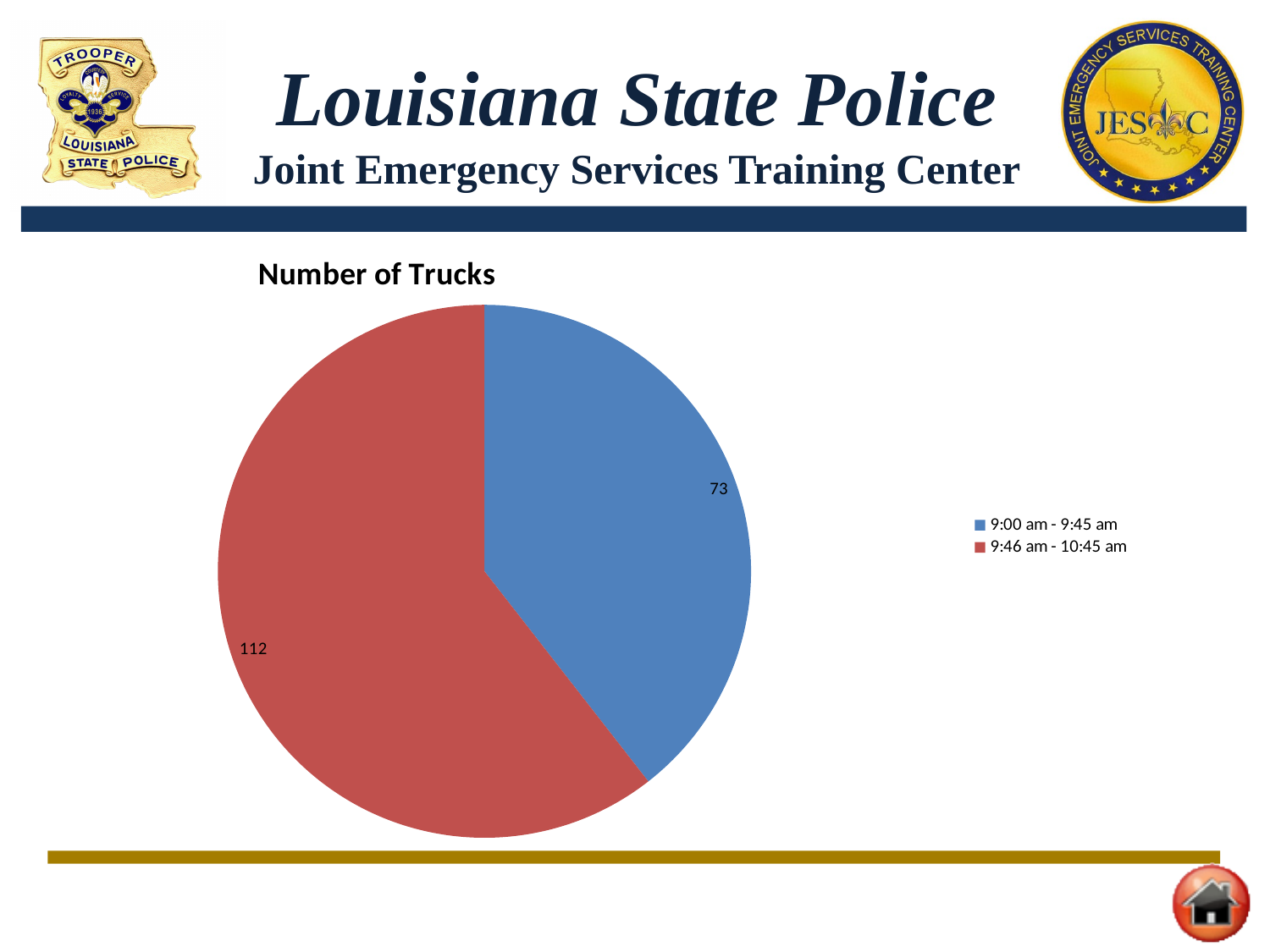
What is the difference in the number of trucks between 9:46 am - 10:45 am and 9:00 am - 9:45 am? 39 What kind of chart is shown on the slide? Pie chart What is the number of trucks for 9:00 am - 9:45 am? 73 Which time period has the lowest number of trucks? 9:00 am - 9:45 am Which has more trucks, 9:00 am - 9:45 am or 9:46 am - 10:45 am? 9:46 am - 10:45 am What is the total number of trucks across both time periods? 185 How many slices does the pie chart have? 2 Which time period has the highest number of trucks? 9:46 am - 10:45 am How many entries does the legend list? 2 What colour is the slice for 9:46 am - 10:45 am? Red What is the title of the chart? Number of Trucks What is the number of trucks for 9:46 am - 10:45 am? 112